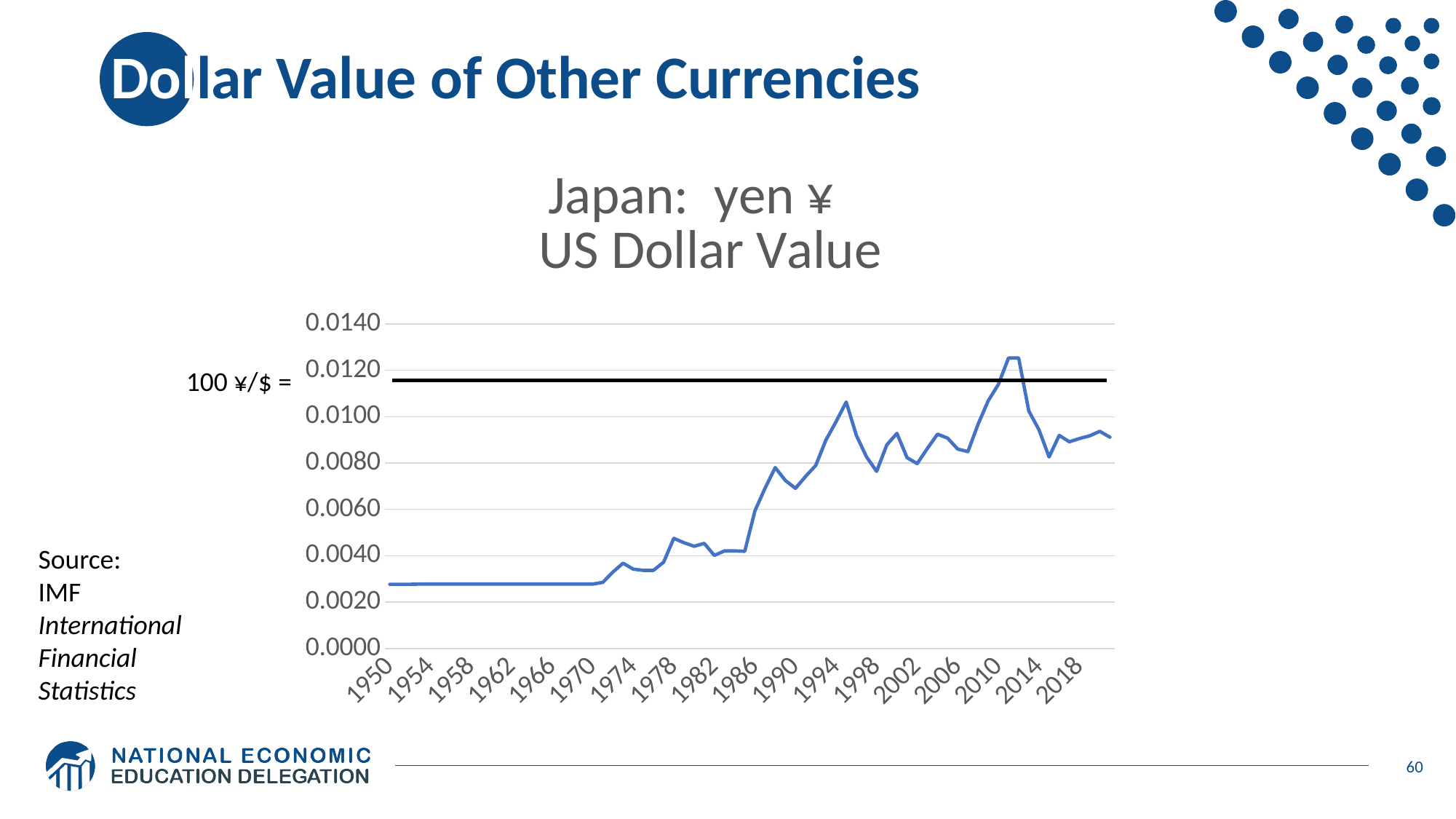
Is the value for 1978 greater or less than 0.0040? greater Is the value for 1950 greater or less than 0.0040? less What kind of chart is shown on the slide? line chart Which is larger, the value for 1950 or the value for 2018? 2018 Is the value for 1990 greater or less than 0.0060? greater How many year labels are shown on the x axis? 18 What is the title of the chart? Japan: yen ¥ US Dollar Value What does the horizontal black reference line on the chart represent? 100 ¥/$ Overall, does the US dollar value of the yen rise or fall from 1950 to 2018? rise